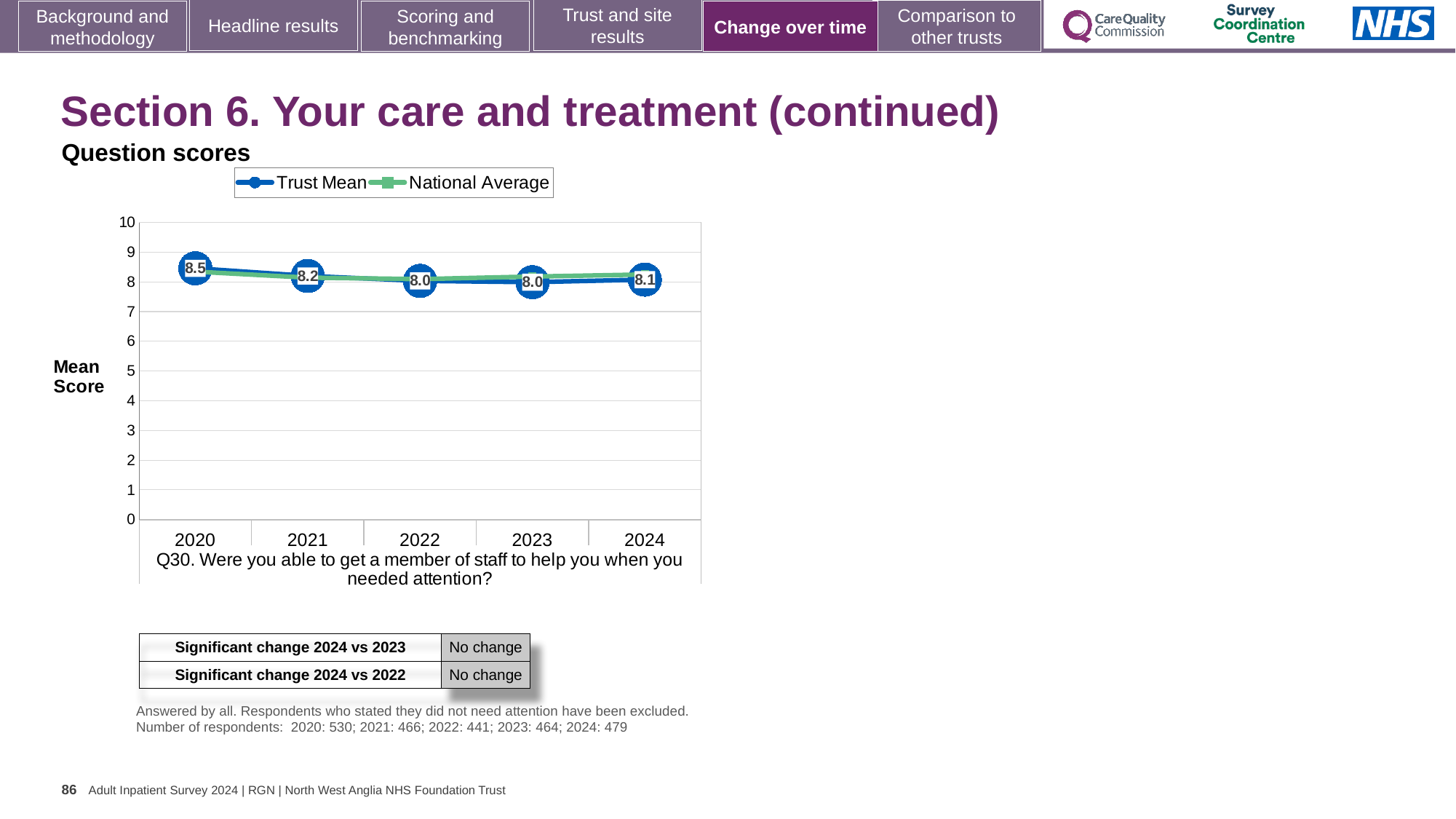
In which year is the Trust Mean score highest? 2020 What is the difference between the Trust Mean score in 2020 and in 2024? 0.4 Which year has the larger Trust Mean score, 2020 or 2021? 2020 What is the Trust Mean score for 2022? 8.0 What are the two series named in the legend? Trust Mean and National Average What kind of chart is shown on the slide? line chart How many years are plotted on the x axis? 5 Does the Trust Mean score rise or fall from 2020 to 2023? fall What is the Trust Mean score for 2024? 8.1 What is the Trust Mean score for 2020? 8.5 Is the National Average value for 2020 greater or less than 8? greater How many series does the legend list? 2